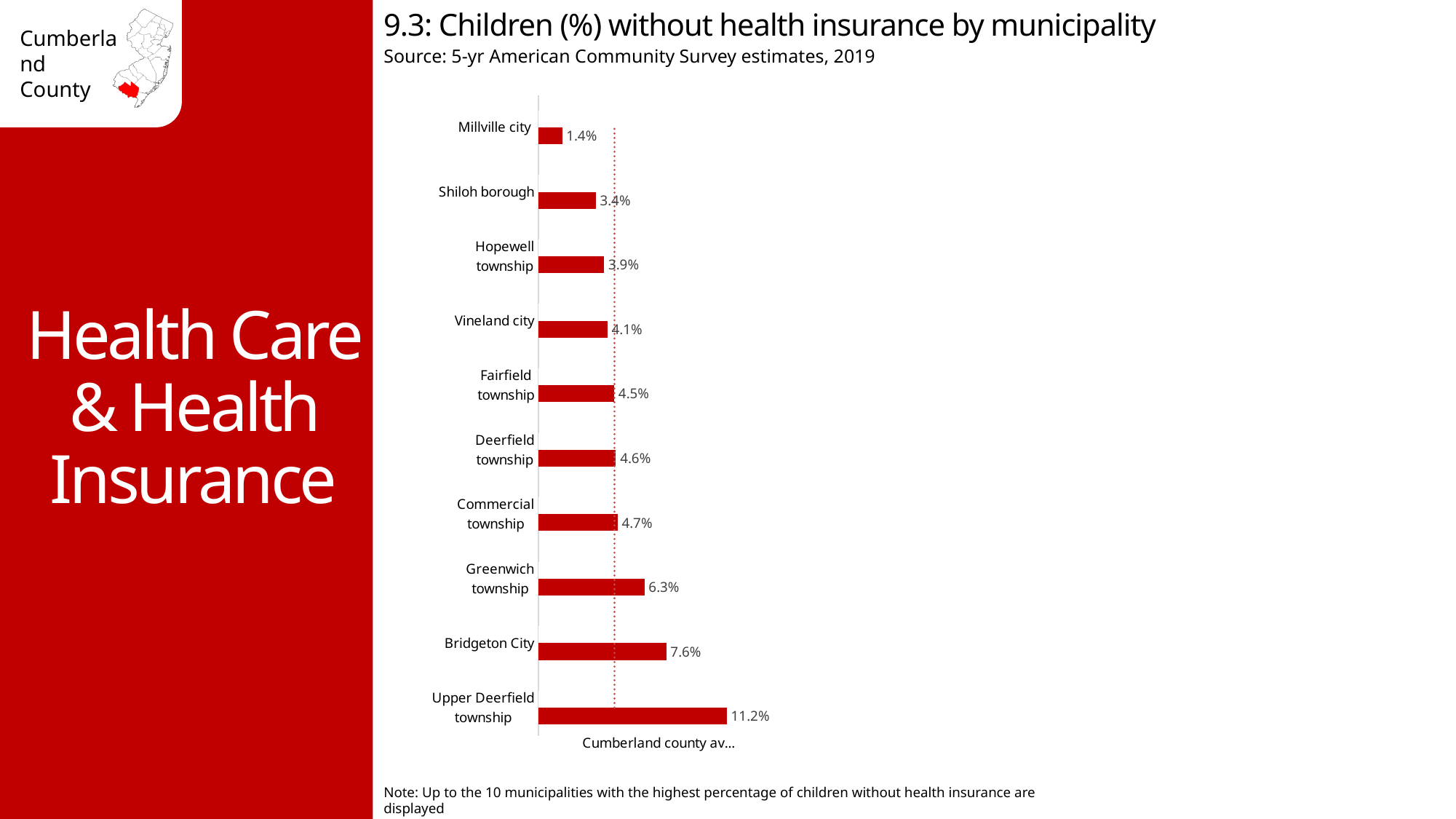
What is the title of the chart? 9.3: Children (%) without health insurance by municipality Which municipality has the highest percentage of children without health insurance? Upper Deerfield township What is the difference between the values for Upper Deerfield township and Bridgeton City? 3.6% Which municipality has the lowest percentage of children without health insurance? Millville city How many municipalities are shown in the chart? 10 What is the value shown for Bridgeton City? 7.6% What percentage is shown for Millville city? 1.4% What percentage of children are without health insurance in Upper Deerfield township? 11.2% What is the difference between the values for Shiloh borough and Millville city? 2.0% What type of chart is used on this slide? Bar chart What is the value for Greenwich township? 6.3% Which has a higher value, Greenwich township or Commercial township? Greenwich township